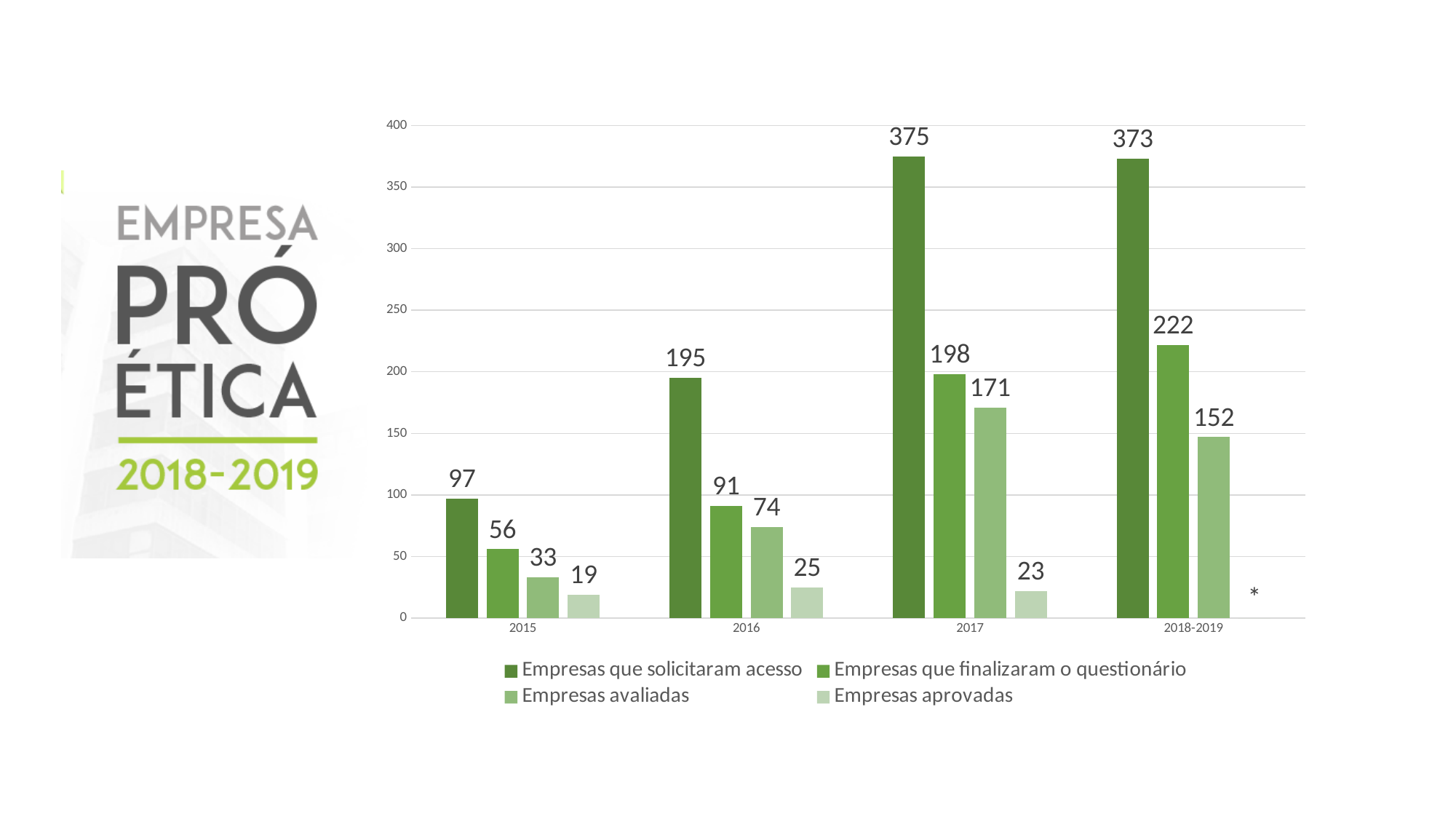
How many series does the legend list? 4 What is the value for 'Empresas aprovadas' in 2015? 19 Which is larger: 'Empresas aprovadas' in 2016 or 'Empresas aprovadas' in 2017? 2016 How many categories are shown on the x axis? 4 What is the value for 'Empresas que finalizaram o questionário' in 2018-2019? 222 In which year is the value for 'Empresas que solicitaram acesso' the lowest? 2015 What is the difference between 'Empresas que solicitaram acesso' and 'Empresas que finalizaram o questionário' in 2016? 104 In which year is the value for 'Empresas avaliadas' the highest? 2017 Does the value for 'Empresas que finalizaram o questionário' rise or fall from 2015 to 2018-2019? Rise What is the value for 'Empresas avaliadas' in 2016? 74 What kind of chart is shown on the slide? Bar chart What is the value for 'Empresas que solicitaram acesso' in 2017? 375